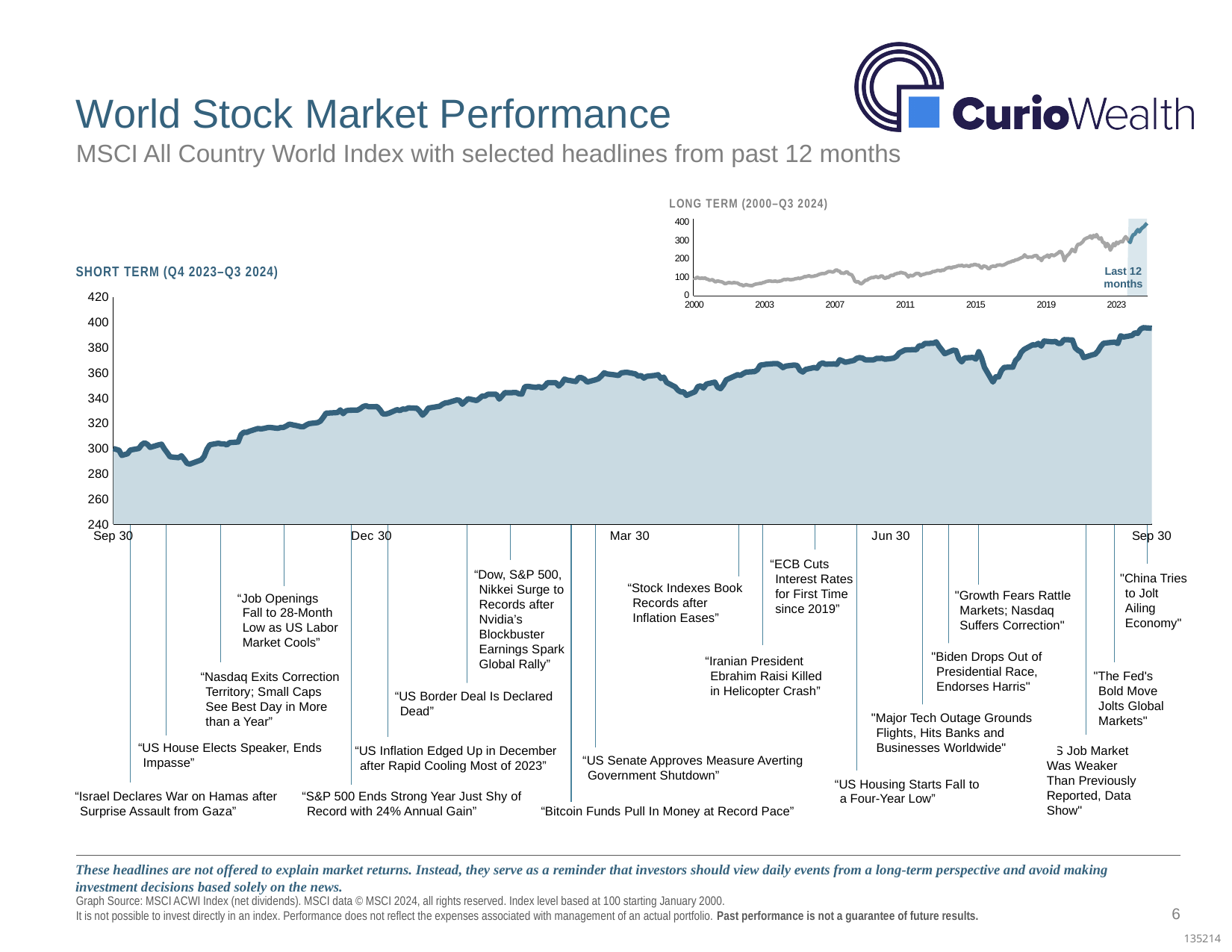
What label is used in the Long Term (2000–Q3 2024) chart to mark the shaded region at the right end of the line? Last 12 months How many date labels are shown on the x axis of the Short Term (Q4 2023–Q3 2024) chart? 5 In the Short Term (Q4 2023–Q3 2024) chart, is the index value at the final Sep 30 greater or less than 380? greater In the Long Term (2000–Q3 2024) chart, is the index value at the end of the series (Q3 2024) greater or less than 300? greater What is the highest value shown on the y axis of the Short Term (Q4 2023–Q3 2024) chart? 420 In the Short Term (Q4 2023–Q3 2024) chart, is the index value at Jun 30 greater or less than 360? greater In the Short Term (Q4 2023–Q3 2024) chart, does the index generally rise or fall from Sep 30 to Sep 30? rise What kind of chart is the Long Term (2000–Q3 2024) chart? line chart In the Long Term (2000–Q3 2024) chart, does the index generally rise or fall from 2000 to 2024? rise What kind of chart is the Short Term (Q4 2023–Q3 2024) chart? line chart